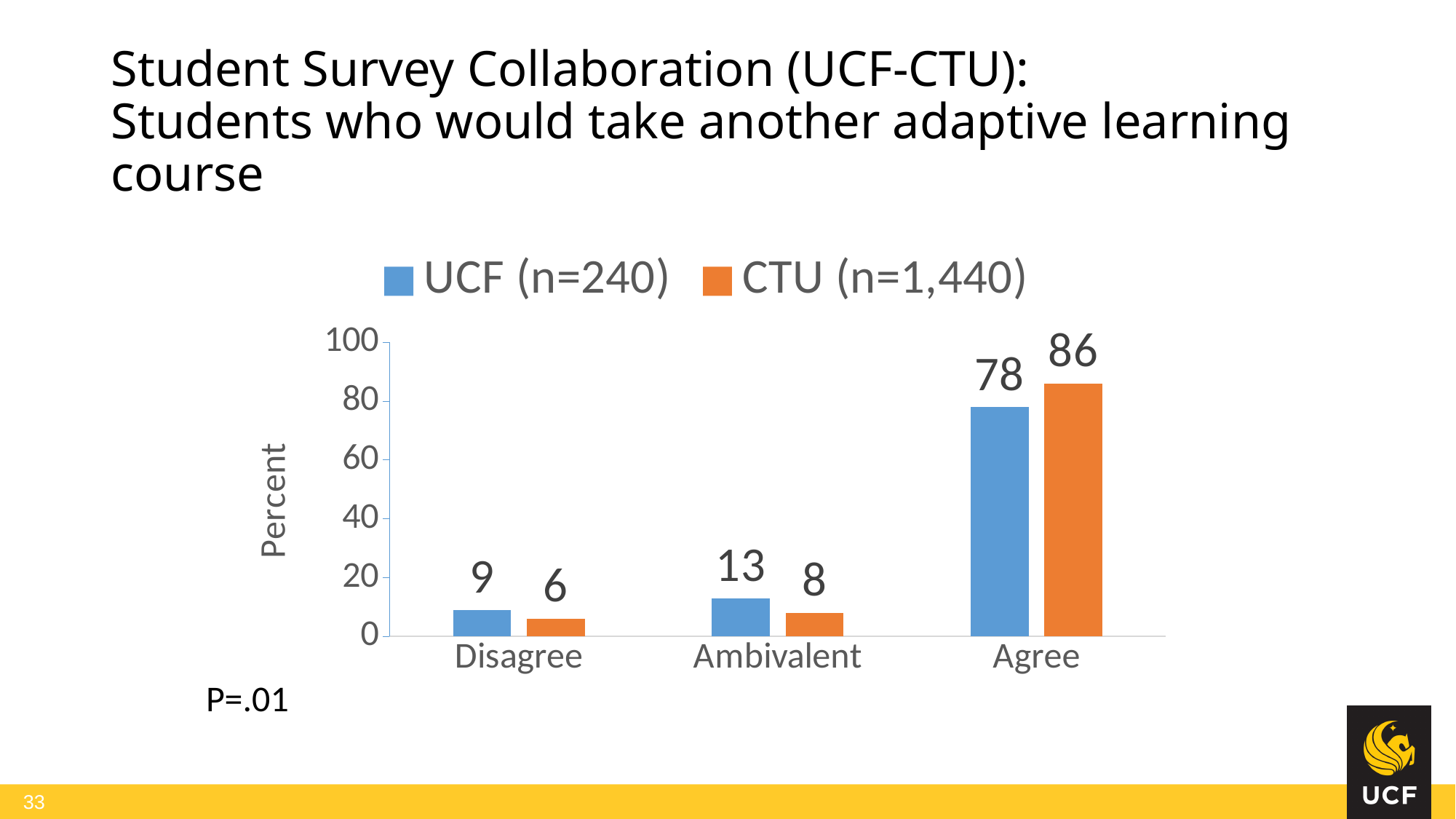
What percent of UCF students agree that they would take another adaptive learning course? 78 Which category has the highest value for CTU (n=1,440)? Agree Is the UCF value for Agree greater or less than 60? greater What kind of chart is shown on the slide? Bar chart Which category has the lowest value for UCF (n=240)? Disagree How many series does the legend list? 2 In the Ambivalent category, which series has the larger value, UCF or CTU? UCF (n=240) What is the label of the y axis? Percent What is the difference between the CTU and UCF values in the Agree category? 8 What is the value for CTU (n=1,440) in the Disagree category? 6 How many categories are shown on the x axis? 3 What percent of CTU students are ambivalent? 8